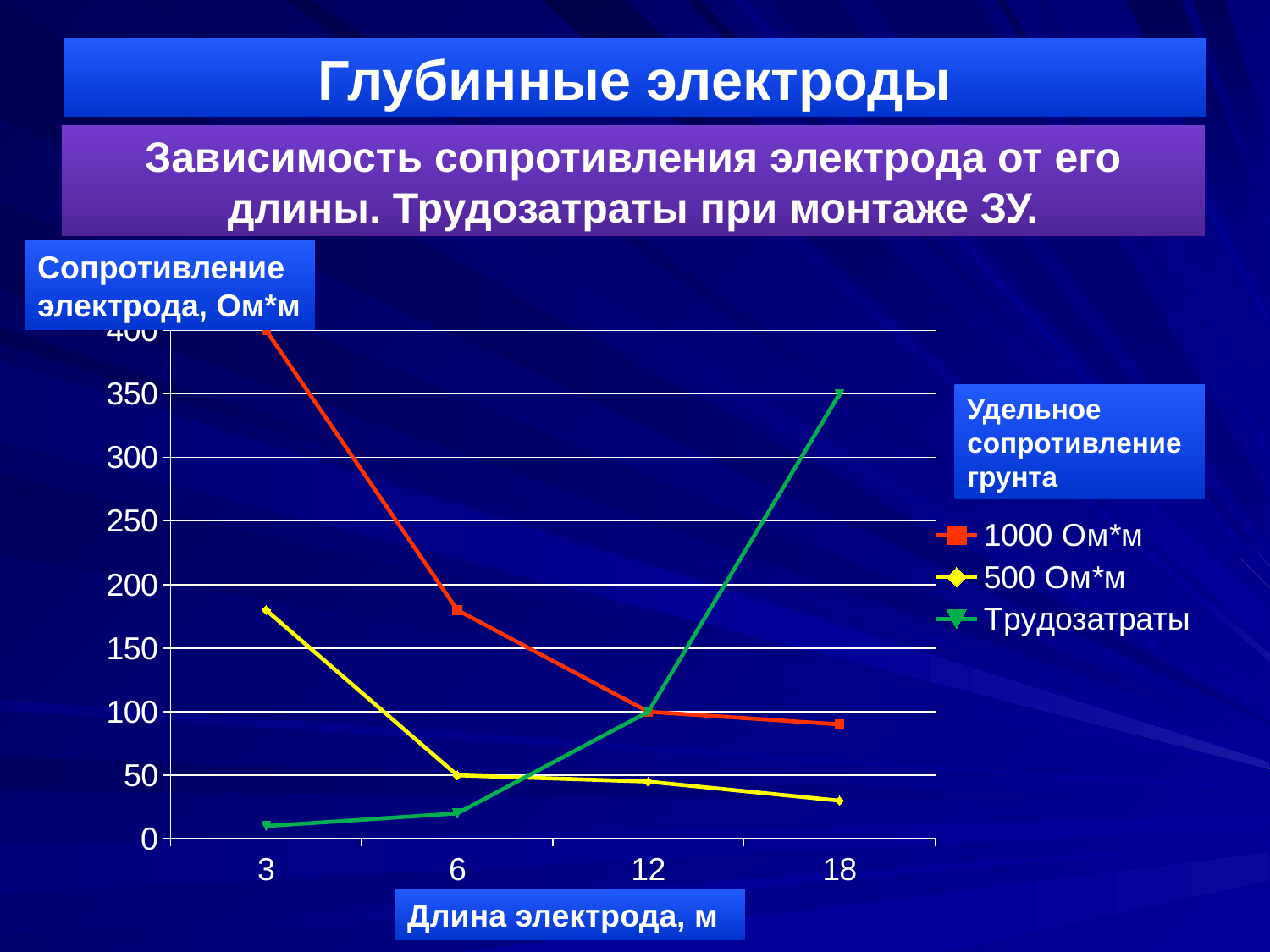
Is the value of the 1000 Ом*м series at electrode length 6 m greater or less than 150? greater What kind of chart is shown on the slide? line chart Is the value of the Трудозатраты series at electrode length 3 m greater or less than 50? less What is the value of the 500 Ом*м series at electrode length 6 m? 50 What is the value of the 1000 Ом*м series at electrode length 12 m? 100 Does the Трудозатраты series rise or fall as electrode length increases from 3 m to 18 m? rise What is the value of the 1000 Ом*м series at electrode length 3 m? 400 Does the 500 Ом*м series rise or fall as electrode length increases from 3 m to 18 m? fall How many electrode length values are plotted along the x axis? 4 How many series does the legend list? 3 Which series is drawn in green? Трудозатраты What is the value of the Трудозатраты series at electrode length 18 m? 350